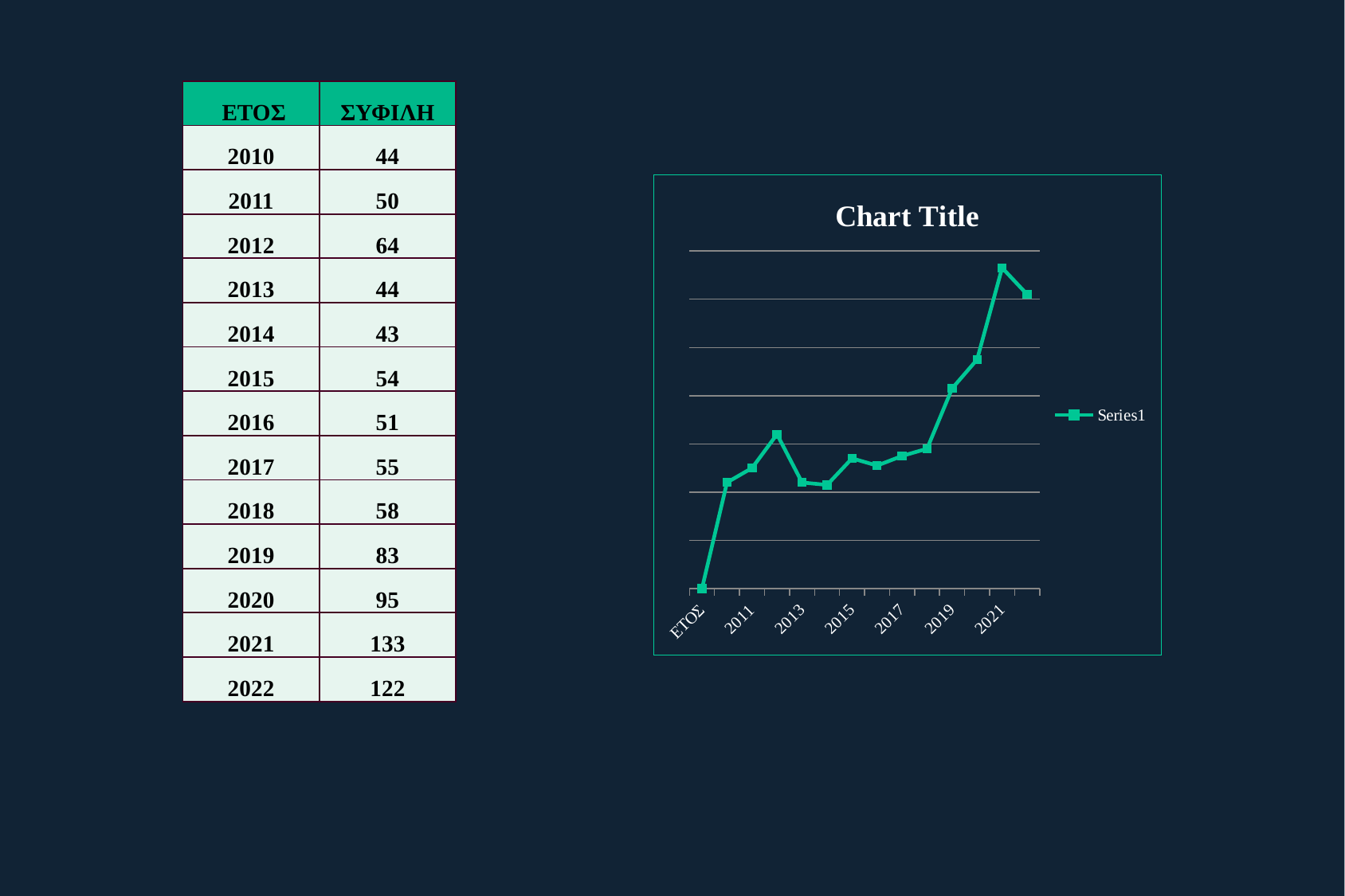
Which year has the highest point on the line chart? 2021 What kind of chart is shown on the slide? Line chart Is the value for 2019 or the value for 2018 larger on the line chart? 2019 How many data points are plotted on the line chart? 14 How many series does the chart legend list? 1 Do the values on the line chart rise or fall from 2012 to 2013? Fall Do the values on the line chart generally rise or fall from 2017 to 2021? Rise Is the value for 2021 or the value for 2022 larger on the line chart? 2021 Is the value for 2012 or the value for 2013 larger on the line chart? 2012 What is the title of the chart? Chart Title What is the name of the series shown in the chart legend? Series1